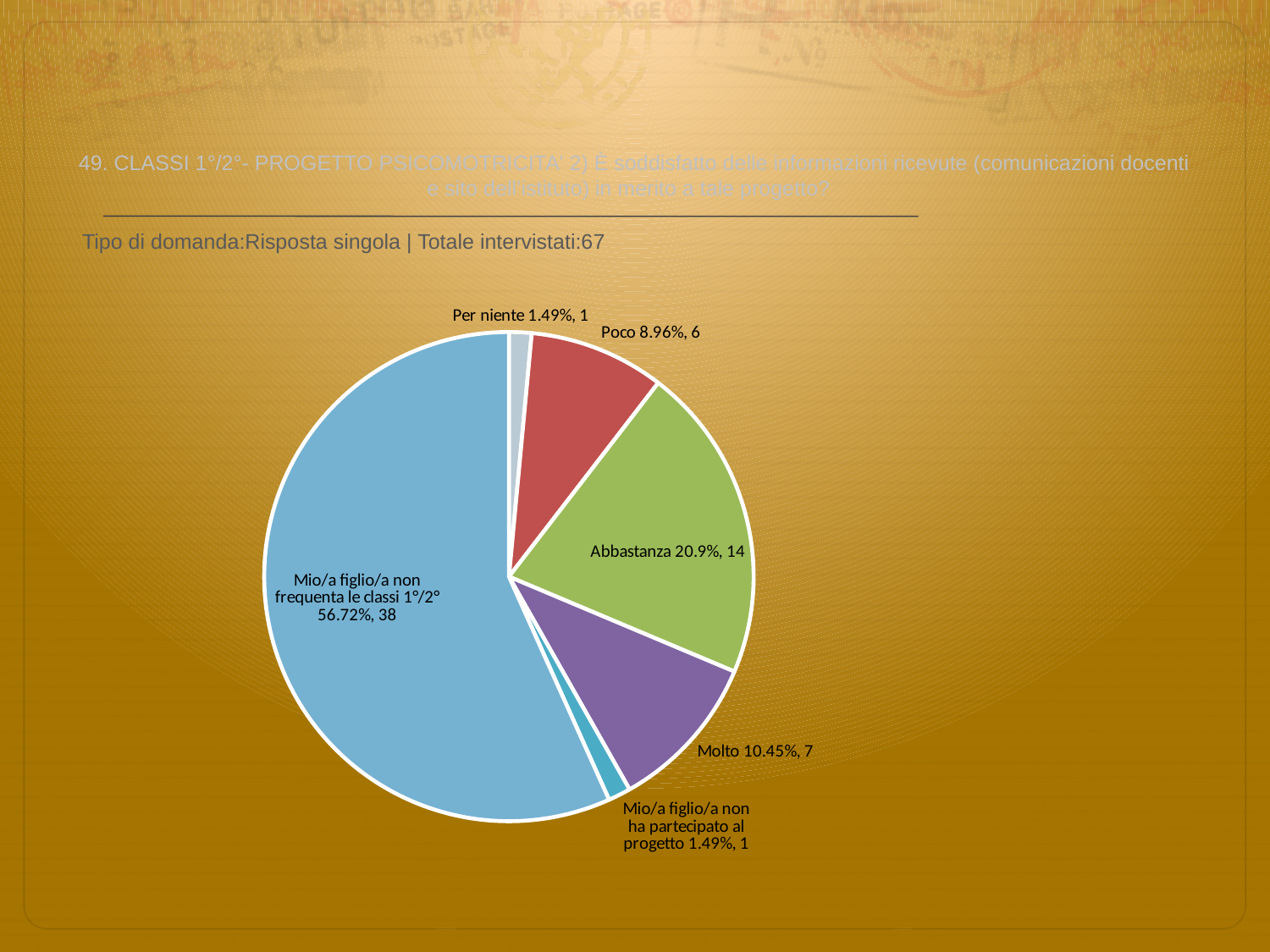
Which category has the largest slice of the pie? Mio/a figlio/a non frequenta le classi 1°/2° What percentage is shown for the "Poco" slice? 8.96% How many respondents answered "Per niente"? 1 How many respondents answered "Molto"? 7 How many slices does the pie chart have? 6 What is the total number of respondents (Totale intervistati) stated on the slide? 67 What is the difference in count between "Abbastanza" and "Poco"? 8 What colour is the "Abbastanza" slice? Green Which slice is larger, "Abbastanza" or "Molto"? Abbastanza What kind of chart is shown on the slide? Pie chart What share of the pie does "Mio/a figlio/a non frequenta le classi 1°/2°" represent? 56.72% What percentage is shown for the "Abbastanza" slice? 20.9%